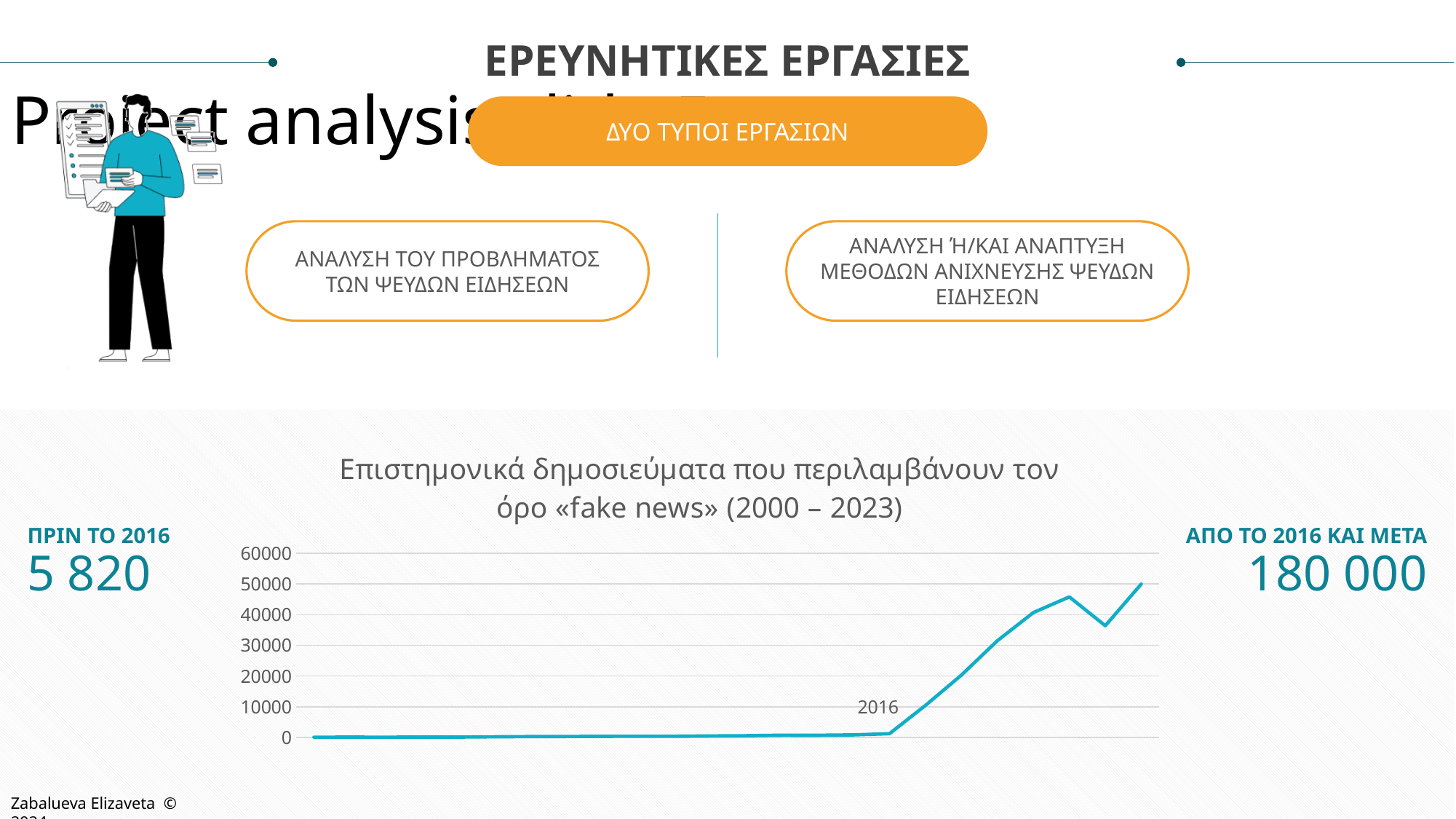
Is the value at the dip after the peak (second-to-last point) greater or less than 40000? less Is the value at the point labelled 2016 greater or less than 10000? less What is the title of the chart on the slide? Επιστημονικά δημοσιεύματα που περιλαμβάνουν τον όρο «fake news» (2000 – 2023) Is the highest value on the line greater or less than 40000? greater Overall, do the values in the chart rise or fall from left to right along the x axis? rise Which year is labelled on the line in the chart? 2016 What is the highest tick value shown on the y axis of the chart? 60000 What kind of chart is shown at the bottom of the slide? line chart